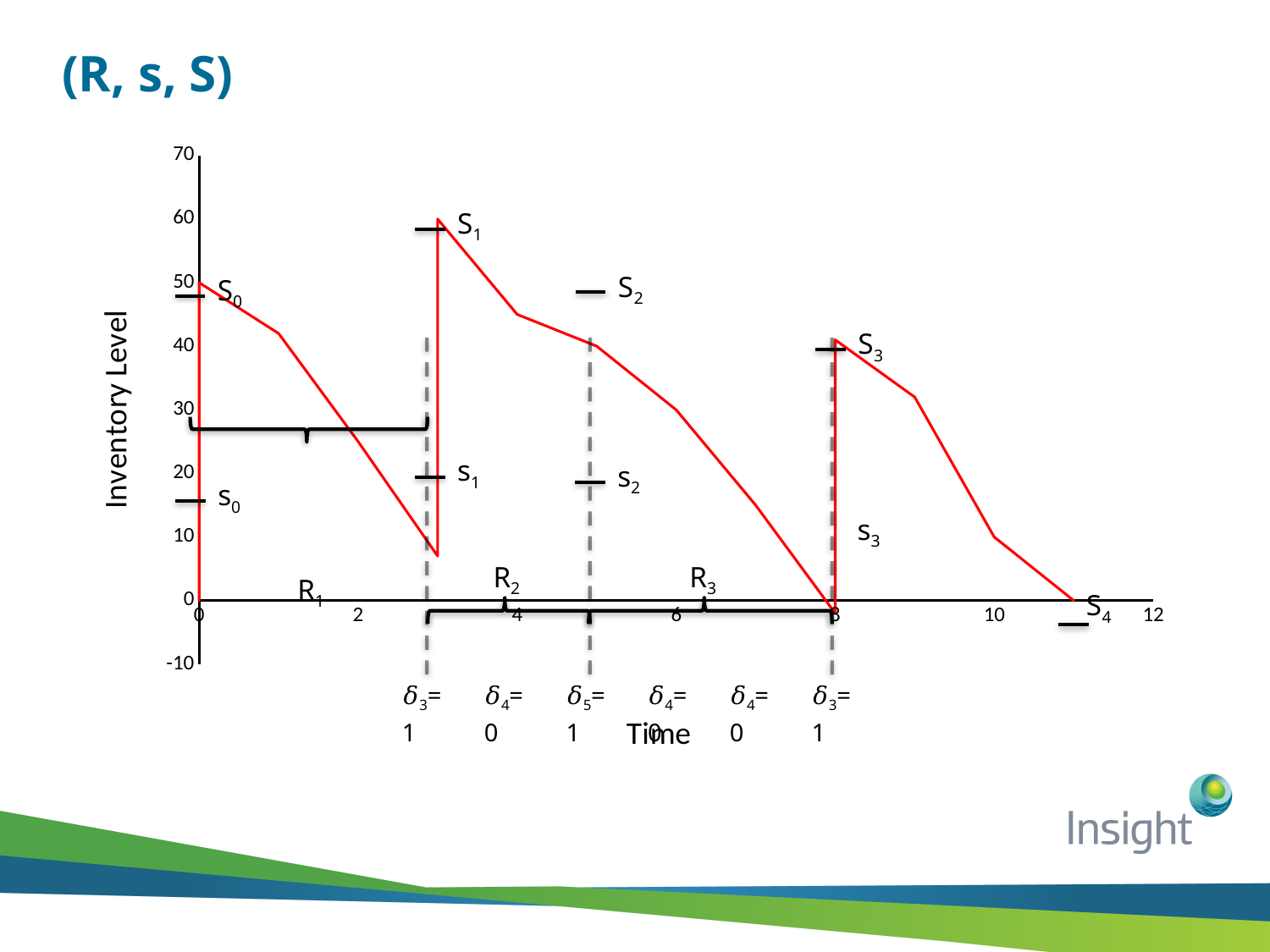
Is the inventory level just before the replenishment at time 3 greater or less than 10? less Which is higher on the chart, the level marked S1 or the level marked S3? S1 What is the label of the horizontal axis? Time Does the inventory level rise or fall between time 3 and time 8? fall What kind of chart is shown on the slide? line chart Is the level marked s0 greater or less than 20? less Is the inventory level immediately after the replenishment at time 3 (marked S1) greater or less than 50? greater How many dashed vertical review lines are drawn on the chart? 3 What is the label of the vertical axis? Inventory Level